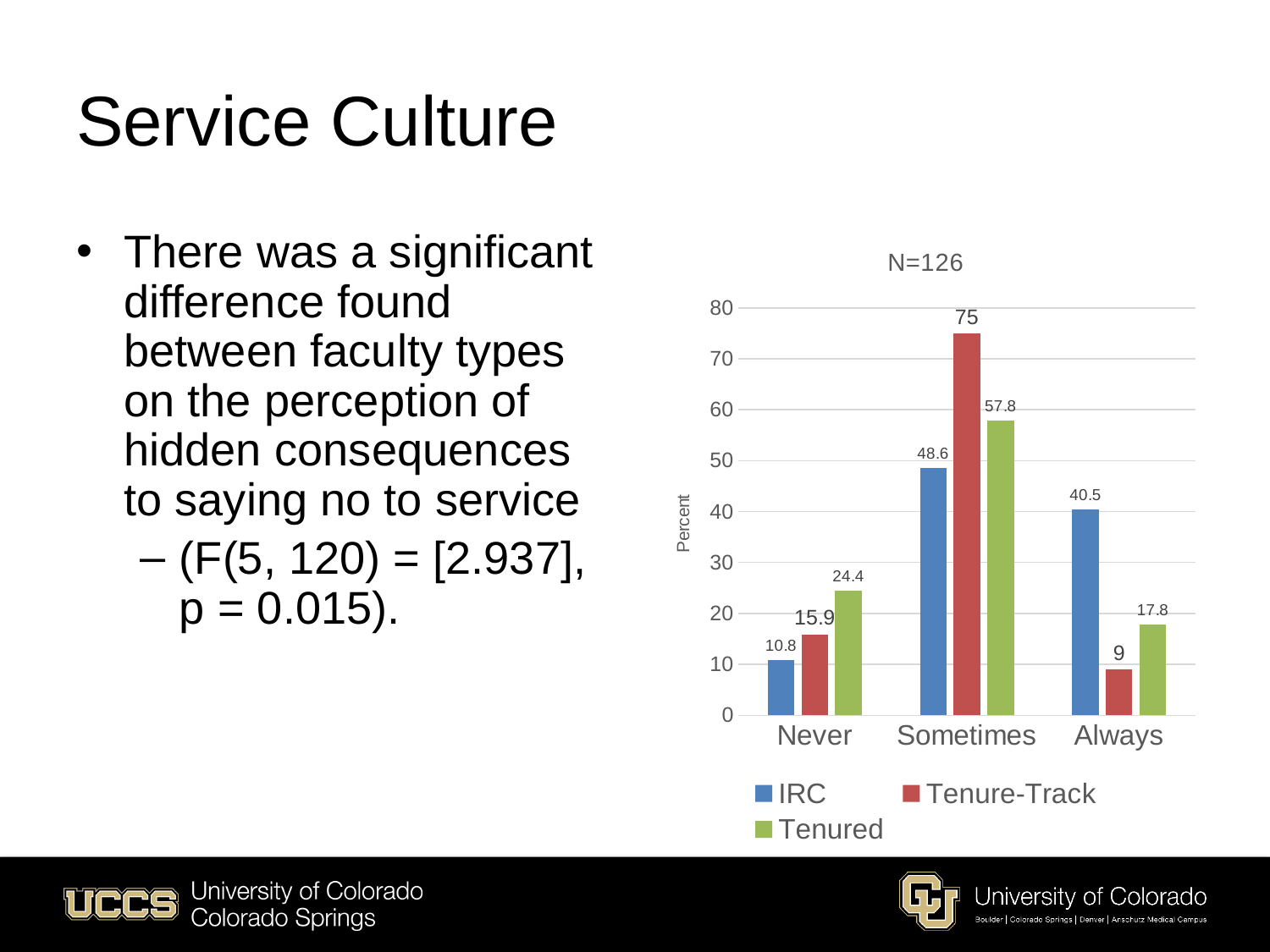
Which category has the highest value for the IRC series? Sometimes What kind of chart is shown on the slide? Bar chart In the Always category, which is larger: the IRC value or the Tenured value? IRC What is the difference between the Tenure-Track and Tenured values in the Sometimes category? 17.2 What is the value for Tenured in the Never category? 24.4 What is the label on the vertical axis of the chart? Percent What is the value for IRC in the Always category? 40.5 Which category has the lowest value for the Tenure-Track series? Always How many series does the legend list? 3 How many categories are shown on the x axis? 3 What is the value for Tenure-Track in the Sometimes category? 75 What is the title of the chart? N=126